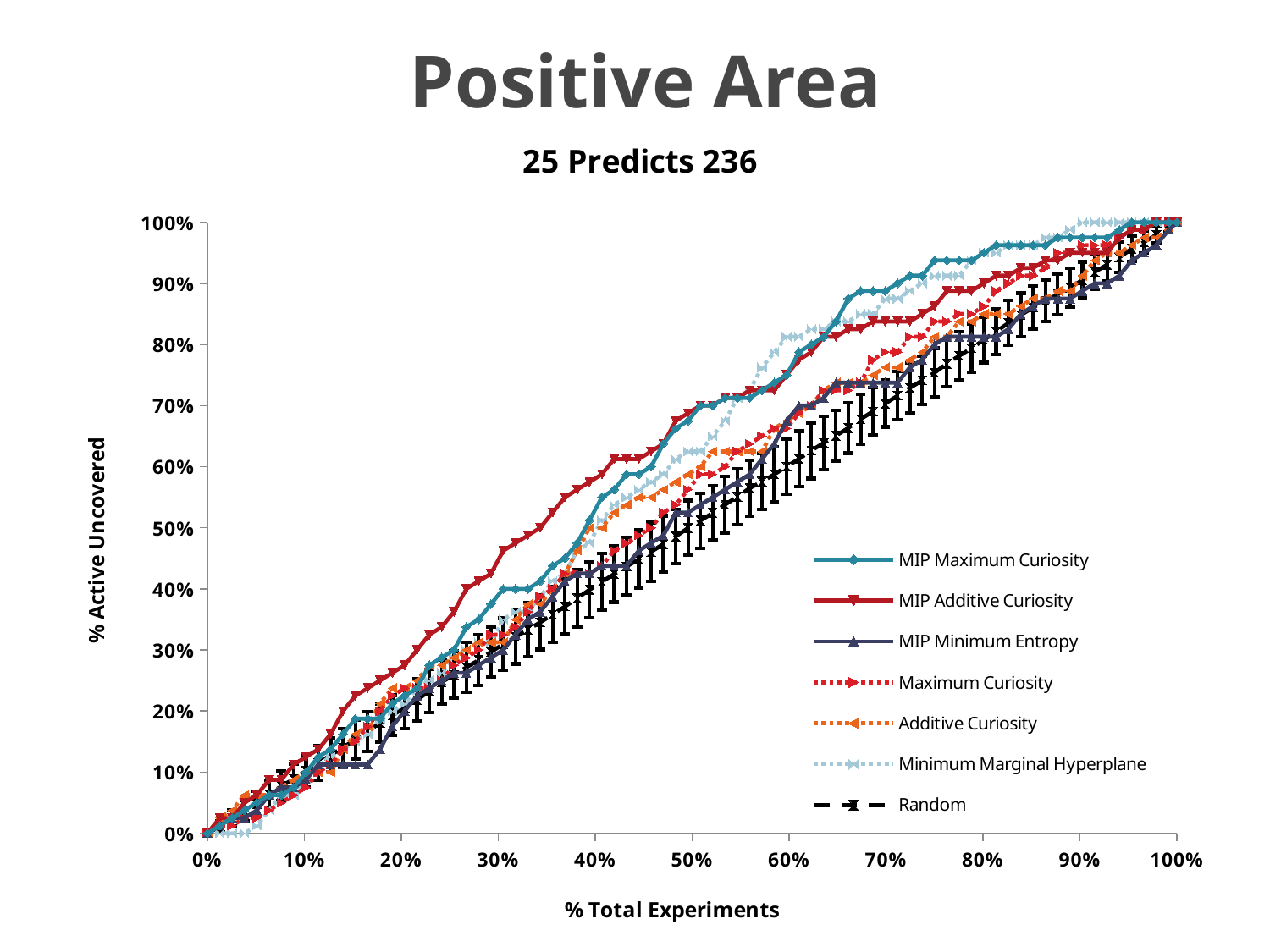
At 30% Total Experiments, which is larger: MIP Additive Curiosity or MIP Minimum Entropy? MIP Additive Curiosity Which series is lowest at 15% Total Experiments? MIP Minimum Entropy At 70% Total Experiments, which is larger: MIP Maximum Curiosity or Random? MIP Maximum Curiosity Which series is highest at 30% Total Experiments? MIP Additive Curiosity Is the value for Random at 60% Total Experiments greater or less than 70%? less What kind of chart is shown on the slide? line chart Is the value for MIP Maximum Curiosity at 70% Total Experiments greater or less than 80%? greater What is the label of the y axis? % Active Uncovered Do the series rise or fall as % Total Experiments increases? rise What value do all series reach at 100% Total Experiments? 100% How many series does the legend list? 7 What is the subtitle of the chart below "Positive Area"? 25 Predicts 236